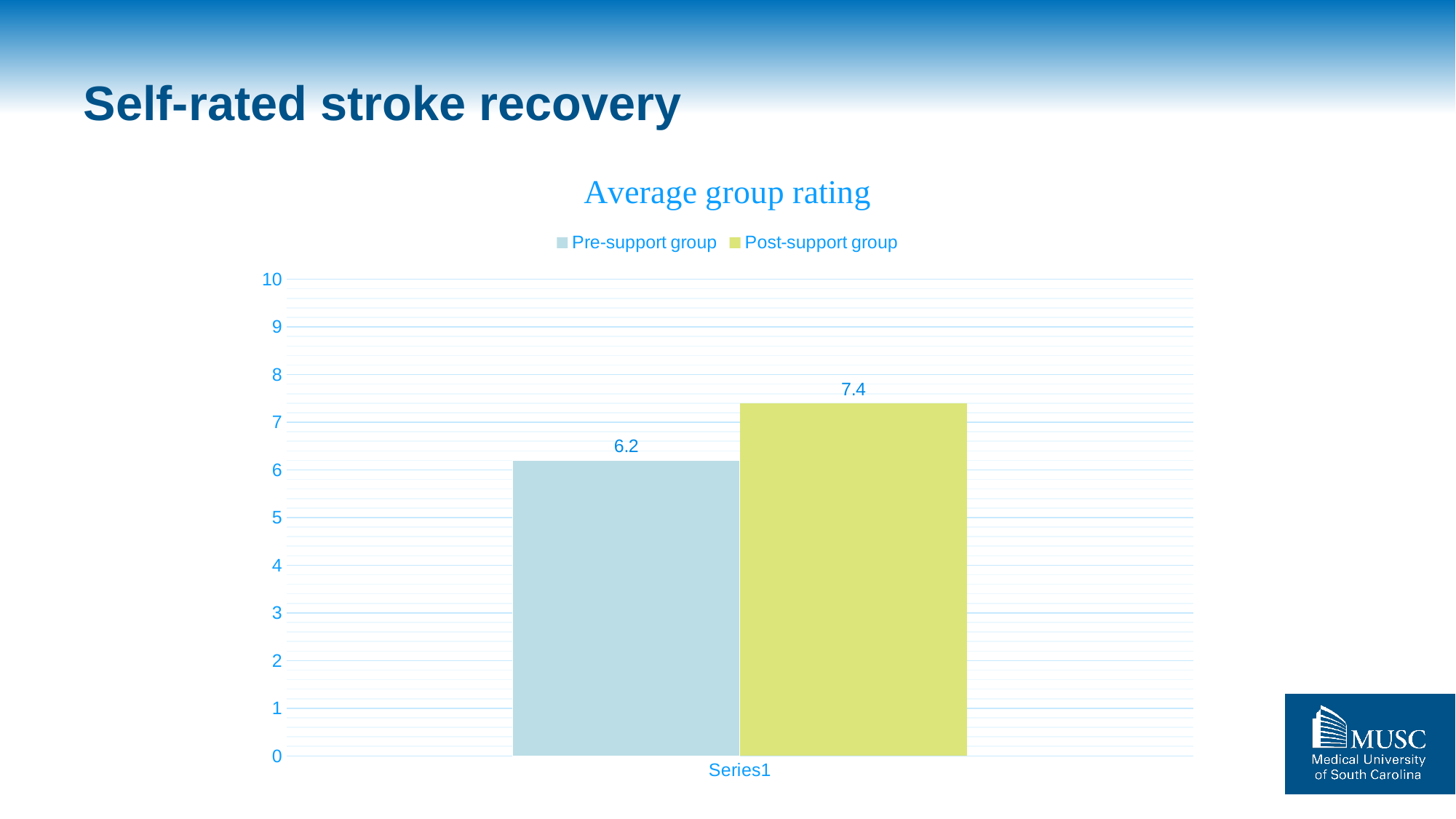
What is the maximum value shown on the vertical axis? 10 Is the value for the Pre-support group greater or less than 6? greater What is the value for the Post-support group? 7.4 What kind of chart is shown? Bar chart What is the value for the Pre-support group? 6.2 Which group has the higher average rating? Post-support group Is the Pre-support group value larger or smaller than the Post-support group value? smaller What is the title of the chart? Average group rating What is the difference between the Post-support group and Pre-support group values? 1.2 How many series does the legend list? 2 Is the value for the Post-support group greater or less than 7? greater Which group has the lower average rating? Pre-support group